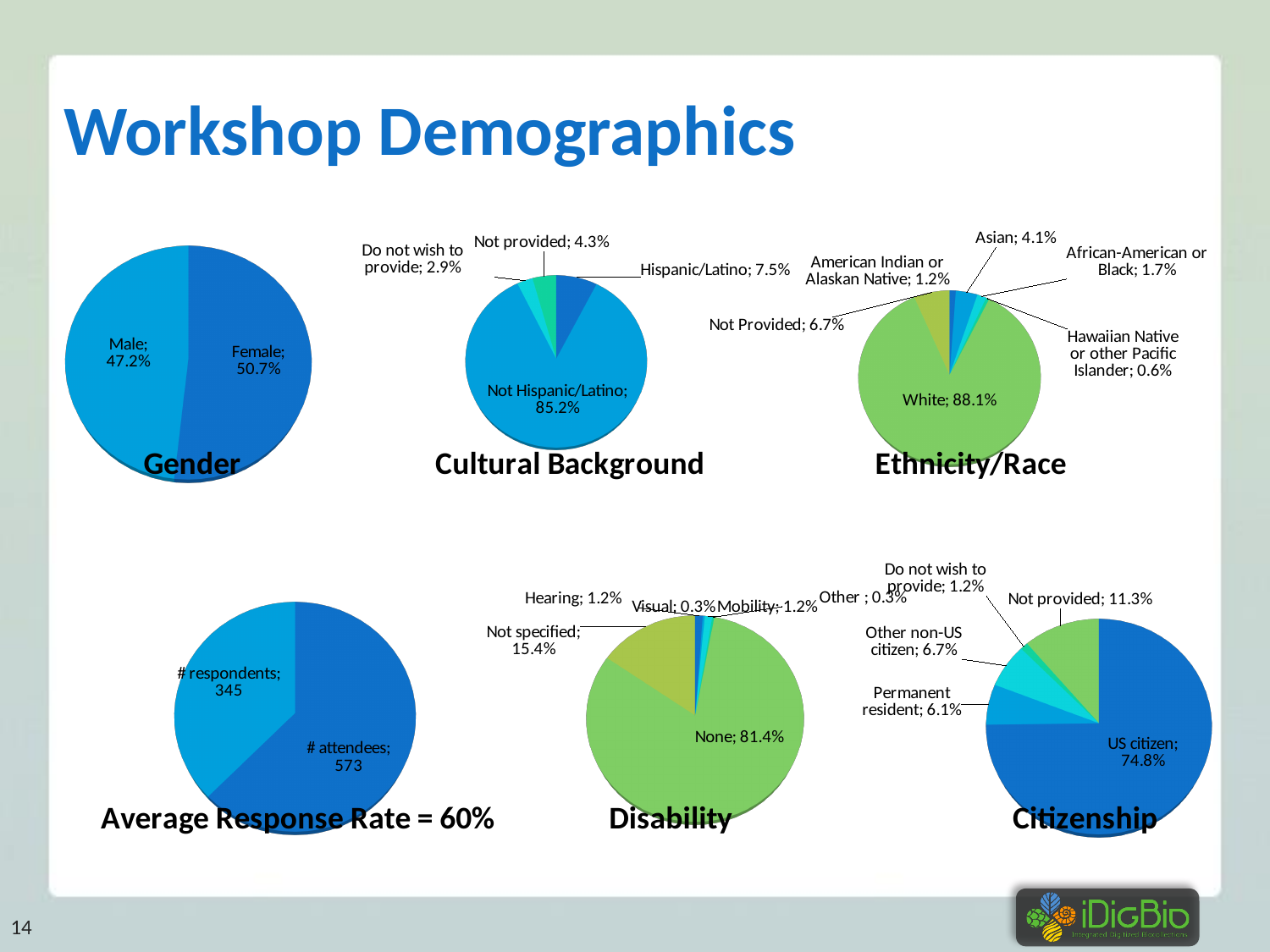
In the Cultural Background chart, what percentage is Not Hispanic/Latino? 85.2% In the Citizenship chart, which is larger: Other non-US citizen or Permanent resident? Other non-US citizen What type of chart is the Gender chart? Pie chart In the Citizenship chart, what percentage is US citizen? 74.8% In the Gender chart, what percentage is Female? 50.7% In the Ethnicity/Race chart, which category has the largest share? White How many pie charts are on the slide? 6 In the Disability chart, how many categories are shown? 6 In the Ethnicity/Race chart, which category has the smallest share? Hawaiian Native or other Pacific Islander In the Ethnicity/Race chart, what is the difference between the Asian and African-American or Black percentages? 2.4% In the Average Response Rate chart, what is the value for # attendees? 573 In the Disability chart, what percentage is Not specified? 15.4%